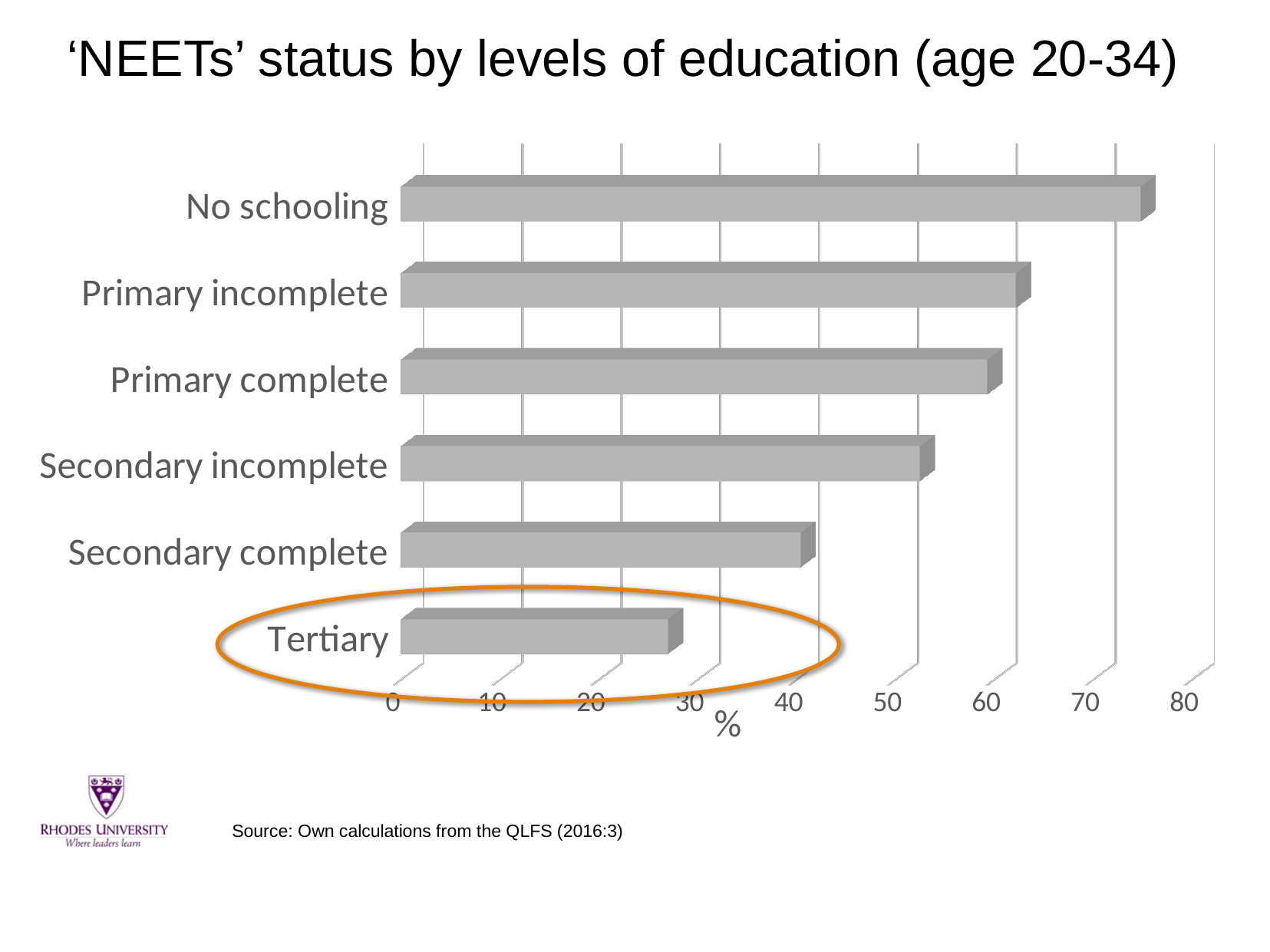
Is the value for No schooling greater or less than 70? greater Is the value for Tertiary greater or less than 30? less Is the value for Secondary incomplete greater or less than 60? less Which education level has the lowest NEET percentage? Tertiary Which has a larger value, Secondary complete or Secondary incomplete? Secondary incomplete What kind of chart is shown on the slide? bar chart Which category on the chart is highlighted with an orange oval? Tertiary How many education levels are shown in the chart? 6 Which education level has the highest NEET percentage? No schooling Do the bar values increase or decrease going from No schooling down to Tertiary? decrease Which has a larger value, No schooling or Tertiary? No schooling